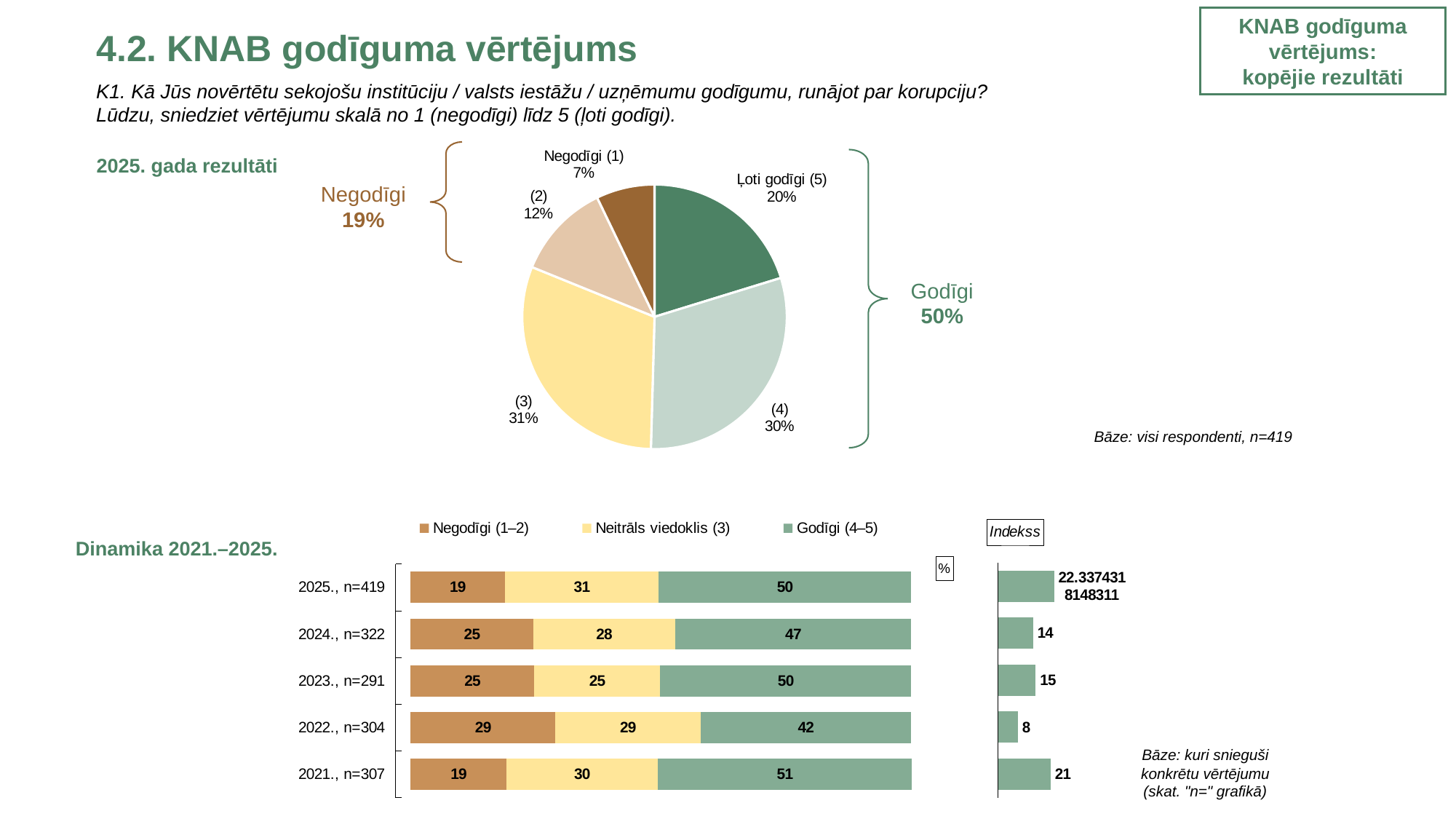
In the pie chart for 2025, what share of respondents gave the rating (3)? 31% In the Indekss chart, which year has the lowest index value? 2022 How many slices does the 2025 pie chart have? 5 In the Dinamika 2021.–2025. stacked bar chart, what is the Negodīgi (1–2) value for 2022? 29 In the Dinamika 2021.–2025. stacked bar chart, what is the difference between the Godīgi (4–5) values for 2023 and 2022? 8 How many series does the legend of the Dinamika 2021.–2025. stacked bar chart list? 3 In the pie chart for 2025, which slice is larger: (2) or Ļoti godīgi (5)? Ļoti godīgi (5) In the pie chart for 2025, which rating has the smallest slice? Negodīgi (1) In the Indekss chart, what is the index value for 2024? 14 In the Dinamika 2021.–2025. stacked bar chart, which year has the highest Godīgi (4–5) value? 2021 What type of chart is the Dinamika 2021.–2025. chart? Stacked bar chart In the pie chart for 2025, what is the combined share of ratings (4) and Ļoti godīgi (5)? 50%